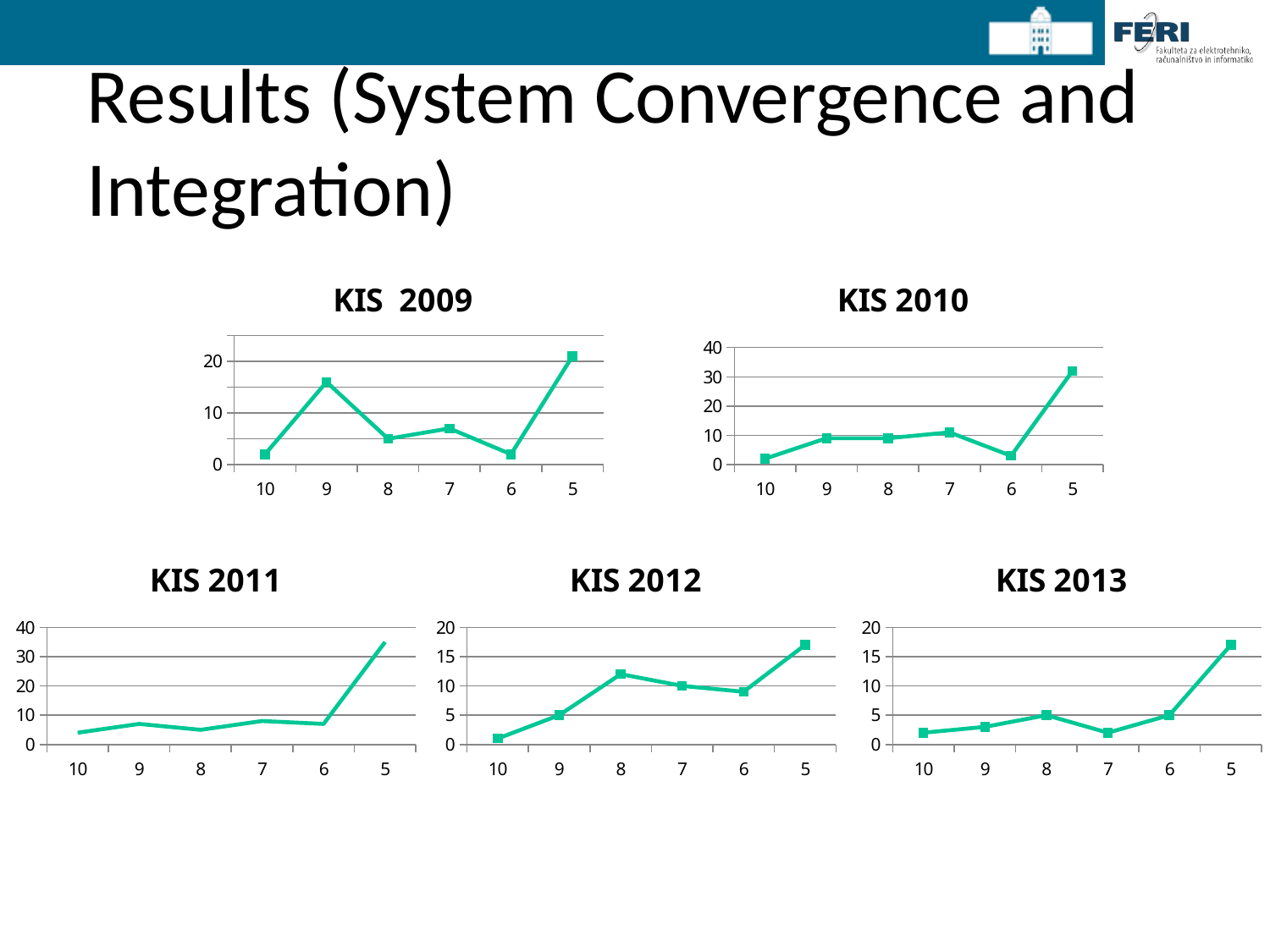
In the KIS 2012 chart, how many data points are plotted? 6 What kind of chart is KIS 2009? line chart In the KIS 2012 chart, which is larger, the value for 8 or the value for 6? 8 How many charts are shown on the slide? 5 In the KIS 2012 chart, which category has the lowest value? 10 In the KIS 2011 chart, which is larger, the value for 5 or the value for 10? 5 In the KIS 2011 chart, is the value for 10 greater or less than 10? less In the KIS 2009 chart, which category has the highest value? 5 In the KIS 2010 chart, is the value for 5 greater or less than 30? greater In the KIS 2013 chart, is the value for 5 greater or less than 15? greater In the KIS 2010 chart, which category has the highest value? 5